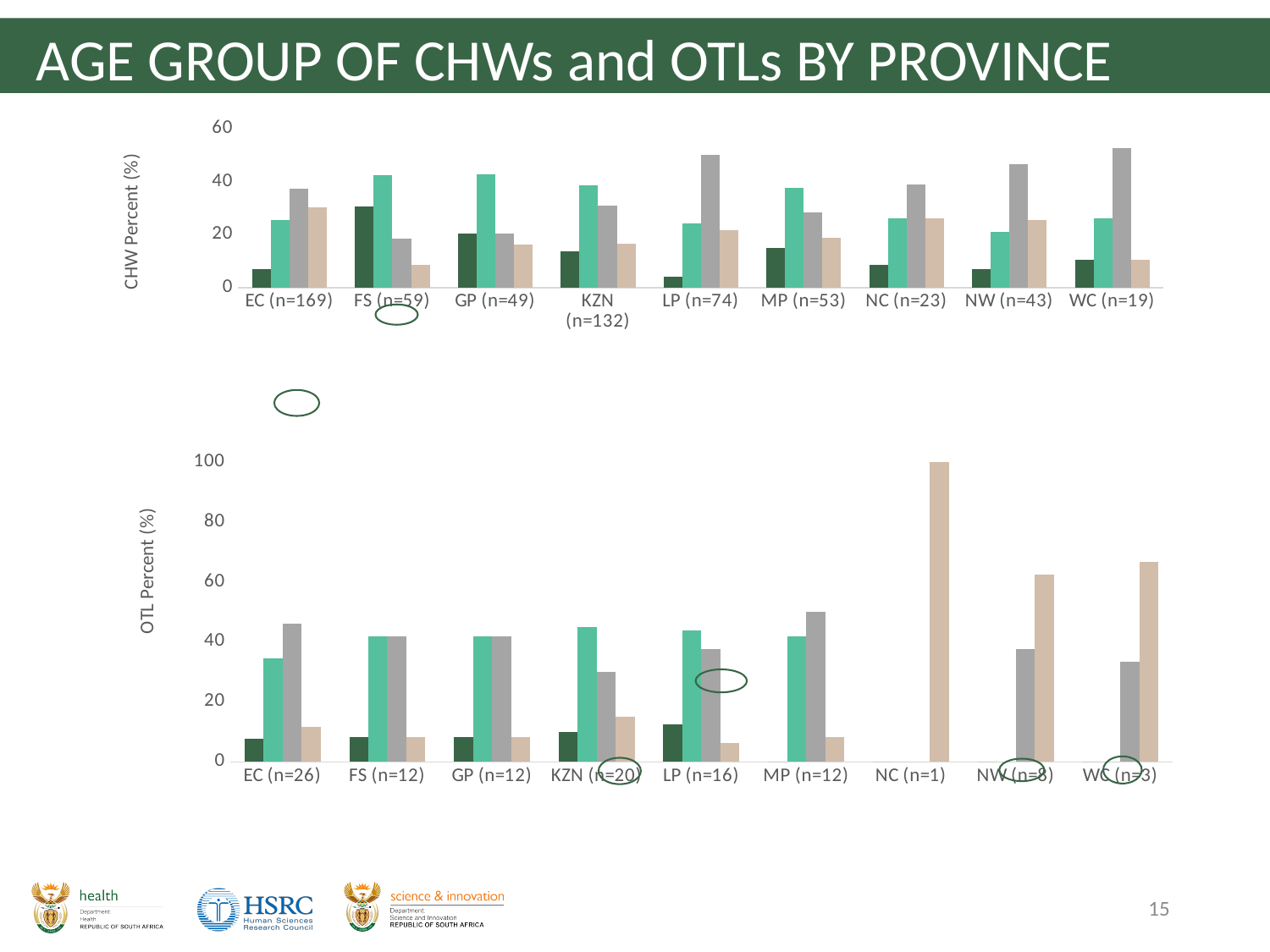
How many provinces are shown on the x axis of the top chart (CHW Percent)? 9 In the bottom chart (OTL Percent), how many bars are shown for NC (n=1)? 1 In the top chart (CHW Percent), which is taller for EC (n=169): the gray bar or the dark green bar? the gray bar In the top chart (CHW Percent), is the dark green bar for EC (n=169) greater or less than 20? less How many provinces are shown on the x axis of the bottom chart (OTL Percent)? 9 What is the y-axis label of the bottom chart? OTL Percent (%) What is the y-axis label of the top chart? CHW Percent (%) In the bottom chart (OTL Percent), which province has the tallest bar? NC (n=1) In the top chart (CHW Percent), is the gray bar for LP (n=74) greater or less than 40? greater In the bottom chart (OTL Percent), is the beige bar for WC (n=3) greater or less than 40? greater What type of chart is the top chart (CHW Percent)? bar chart